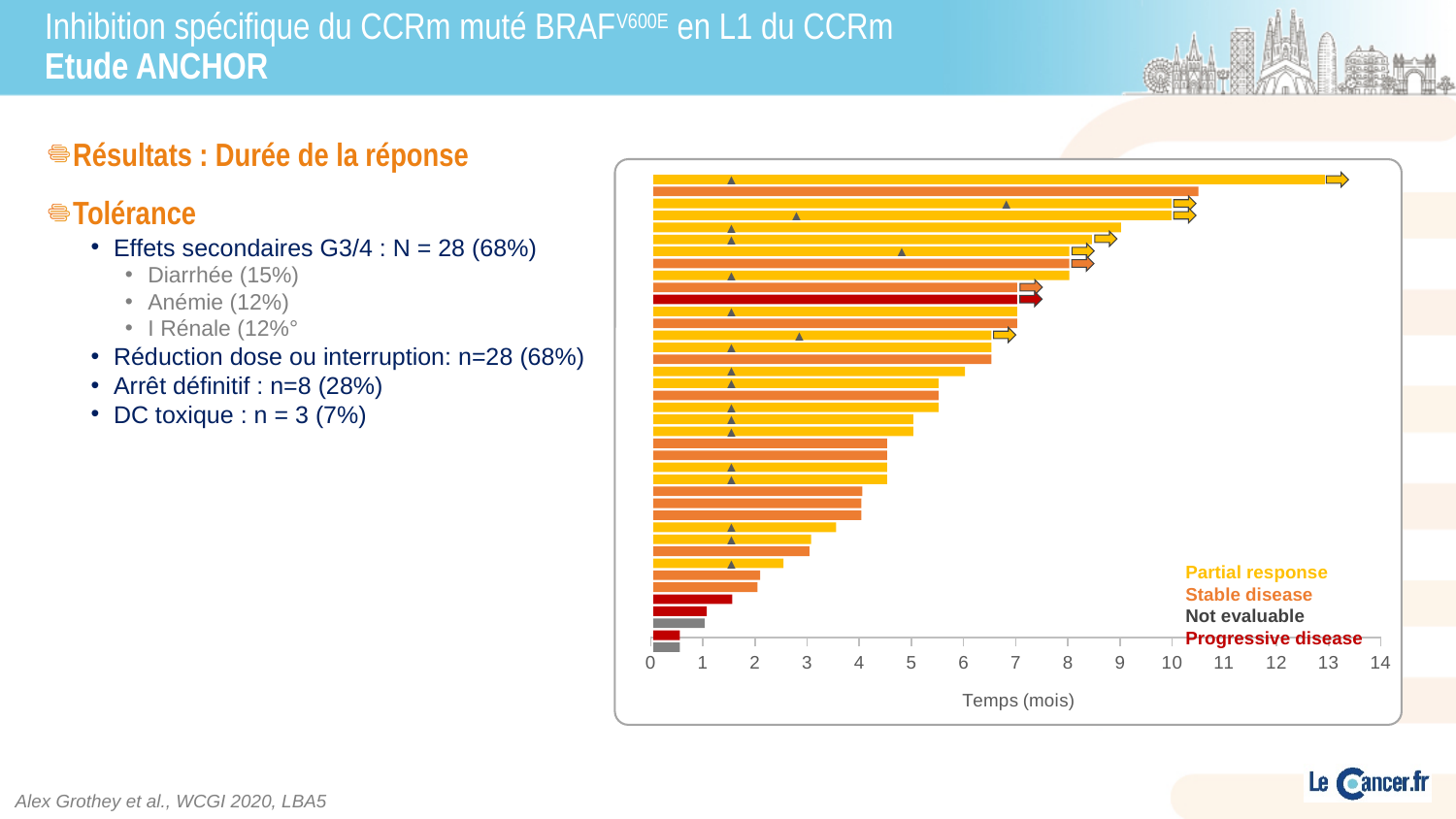
How many categories does the legend of the chart list? 4 What is the label of the x axis of the chart? Temps (mois) Is the length of the longest bar in the chart greater or less than 12 months? greater How many red (Progressive disease) bars are shown in the chart? 3 What kind of chart is shown on the slide? bar chart What is the highest value shown on the x axis of the chart? 14 Is the longest red (Progressive disease) bar in the chart greater or less than 6 months? greater Is the longest bar in the chart longer or shorter than the longest red (Progressive disease) bar? longer Is the length of the shortest bar in the chart greater or less than 1 month? less Do the bar lengths in the chart increase or decrease from the top of the chart to the bottom? decrease